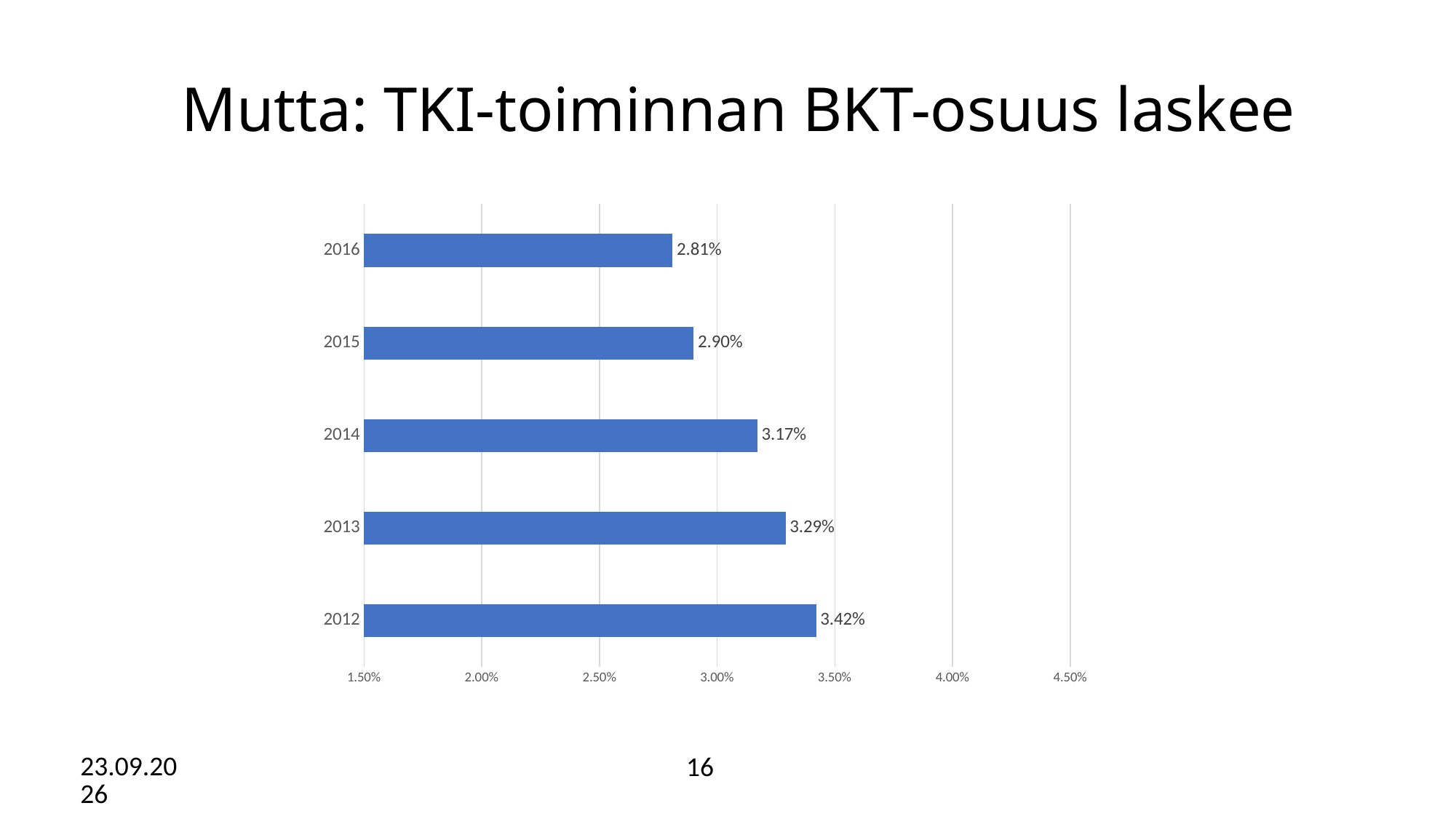
How many years are shown in the chart? 5 Which year has the highest value? 2012 What is the value for 2013? 3.29% What is the difference between the values for 2012 and 2016? 0.61% What is the value for 2016? 2.81% Which is larger, the value for 2013 or the value for 2015? 2013 Which year has the lowest value? 2016 What is the difference between the values for 2015 and 2014? 0.27% Is the value for 2015 greater or less than 3.00%? less What is the title of the slide? Mutta: TKI-toiminnan BKT-osuus laskee What is the value for 2014? 3.17% What kind of chart is shown on the slide? bar chart